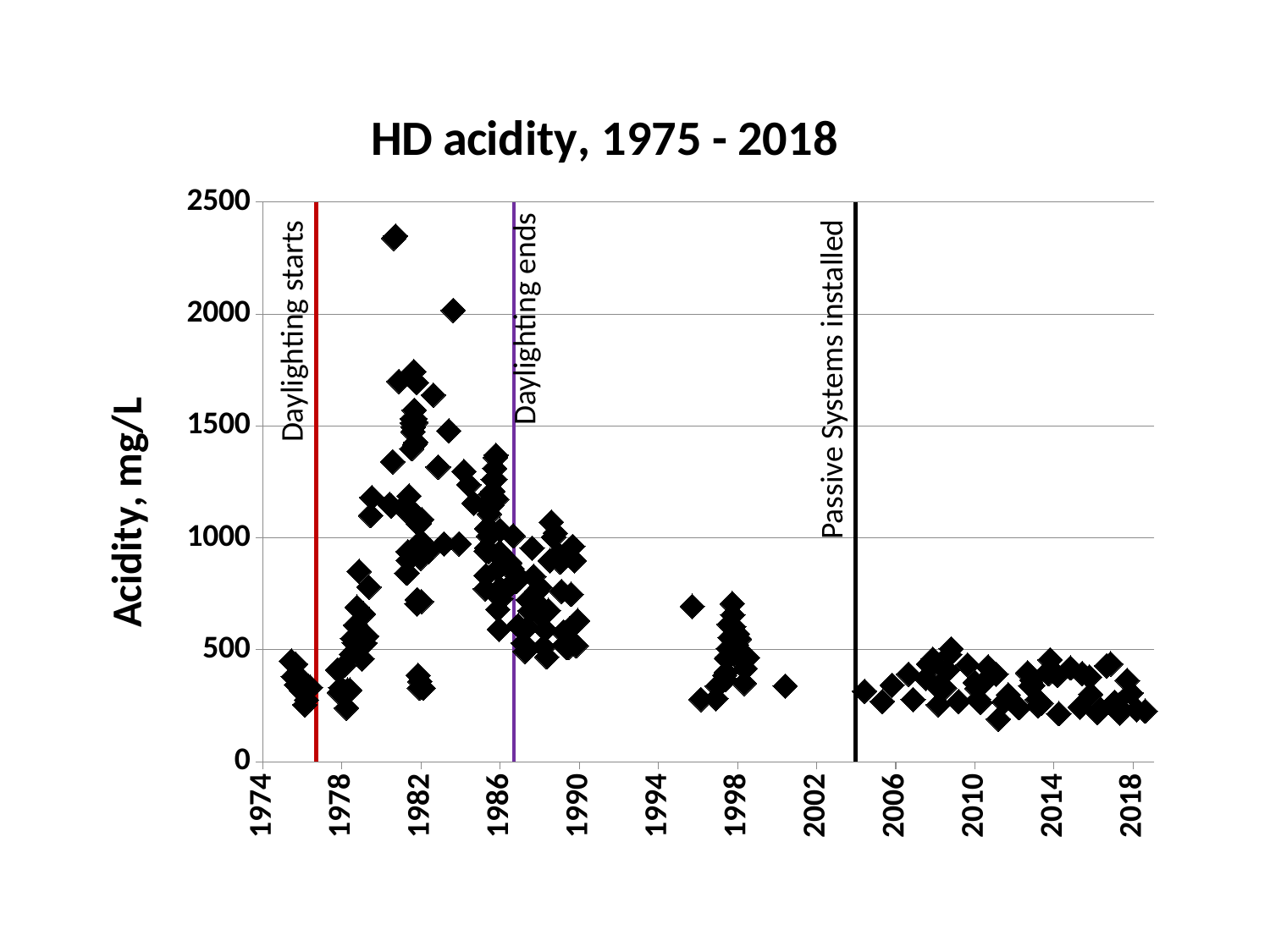
Is the highest plotted acidity value (around 1981) greater or less than 2000? greater What is the label of the vertical axis? Acidity, mg/L Are the acidity values plotted around 1998 greater or less than 1000? less Are the acidity values plotted in 1975 greater or less than 500? less Do the acidity values rise or fall between 1975 and 1981? rise What is the maximum value shown on the vertical axis? 2500 What is the title of the chart? HD acidity, 1975 - 2018 Overall, do the acidity values rise or fall from the early 1980s to 2018? fall What kind of chart is shown on the slide? scatter chart